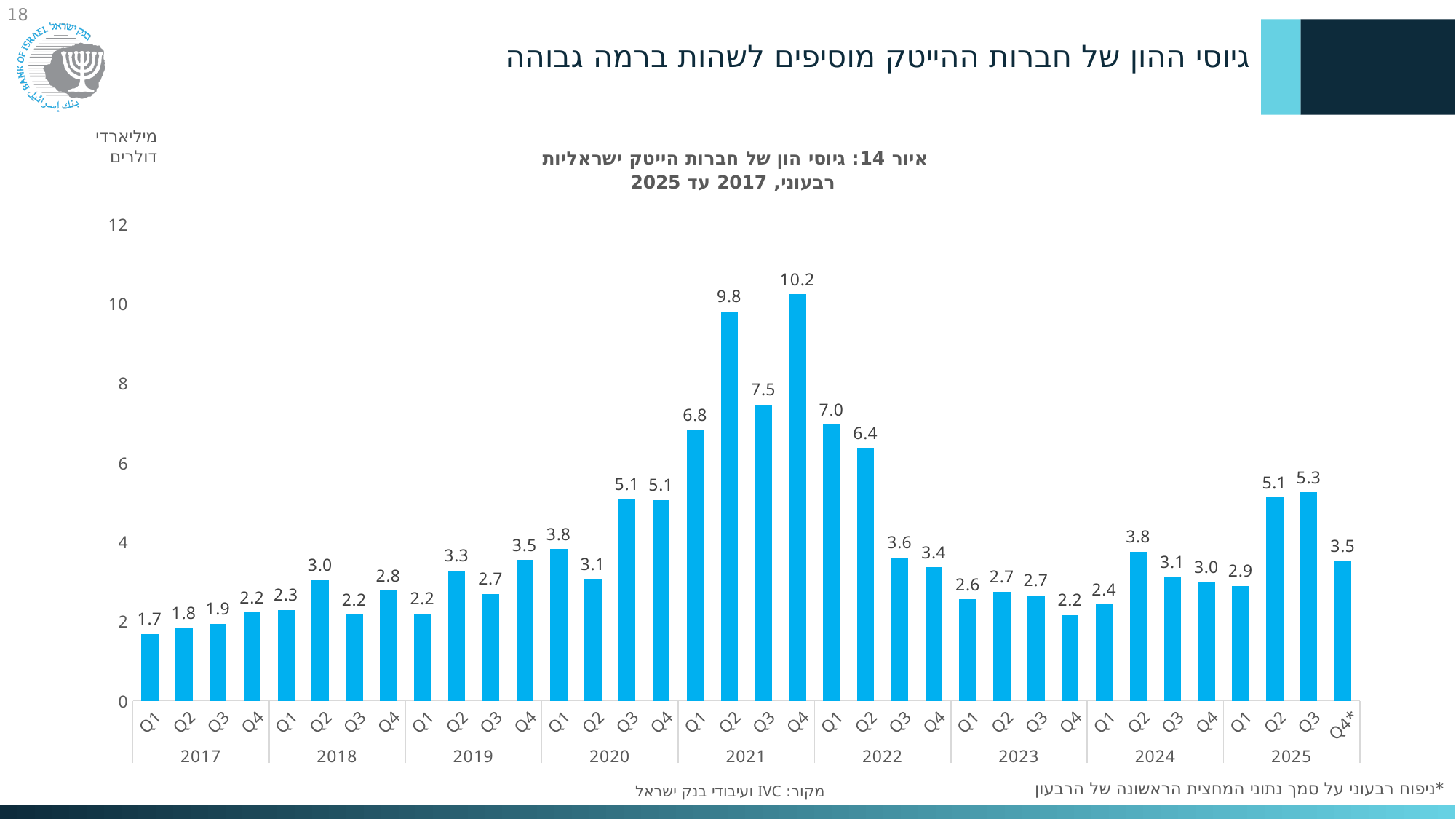
What is the value for Q2 2025? 5.1 Which quarter has the lowest value? Q1 2017 What is the difference between the values for Q3 2025 and Q4* 2025? 1.8 Is the value for Q1 2021 greater or less than 6? greater What is the difference between the values for Q2 2021 and Q3 2021? 2.3 What is the value for Q1 2017? 1.7 What is the value for Q4 2021? 10.2 Which is larger, the value for Q1 2022 or the value for Q2 2022? Q1 2022 What kind of chart is shown on the slide? Bar chart How many bars are plotted in the chart? 36 Which quarter has the highest value? Q4 2021